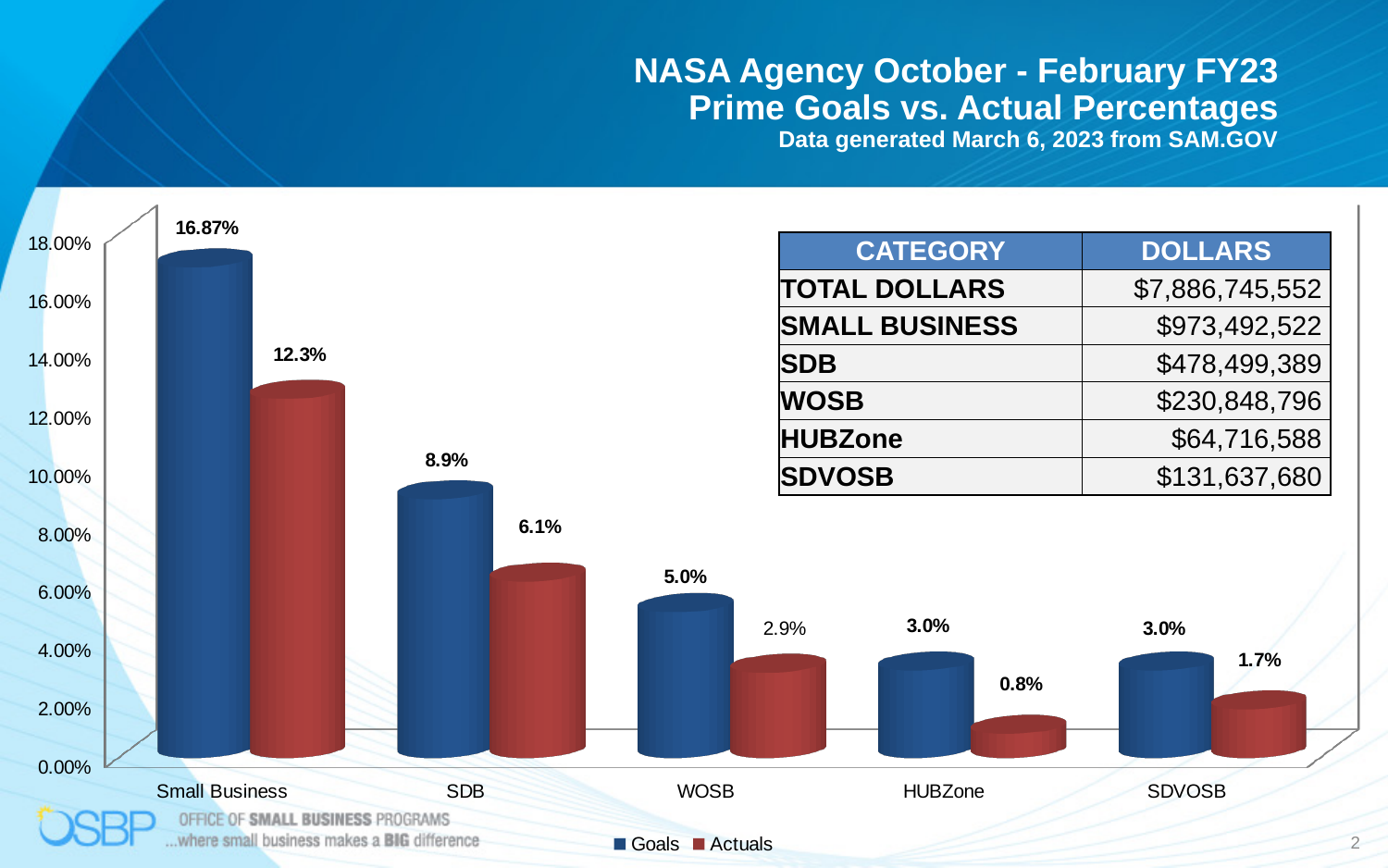
What is the Actuals value for SDB? 6.1% How many categories are shown on the x axis of the chart? 5 What is the difference between the Goals and Actuals values for SDB? 2.8% Which category has the lowest Actuals value? HUBZone What colour are the Actuals bars in the chart? Red Which category has the highest Actuals value? Small Business What kind of chart is shown on the slide? Bar chart How many series does the chart legend list? 2 Which is larger, the Actuals value for SDVOSB or the Actuals value for HUBZone? SDVOSB What is the Actuals value for HUBZone? 0.8% What is the Goals value for WOSB? 5.0% What is the Goals value for Small Business? 16.87%